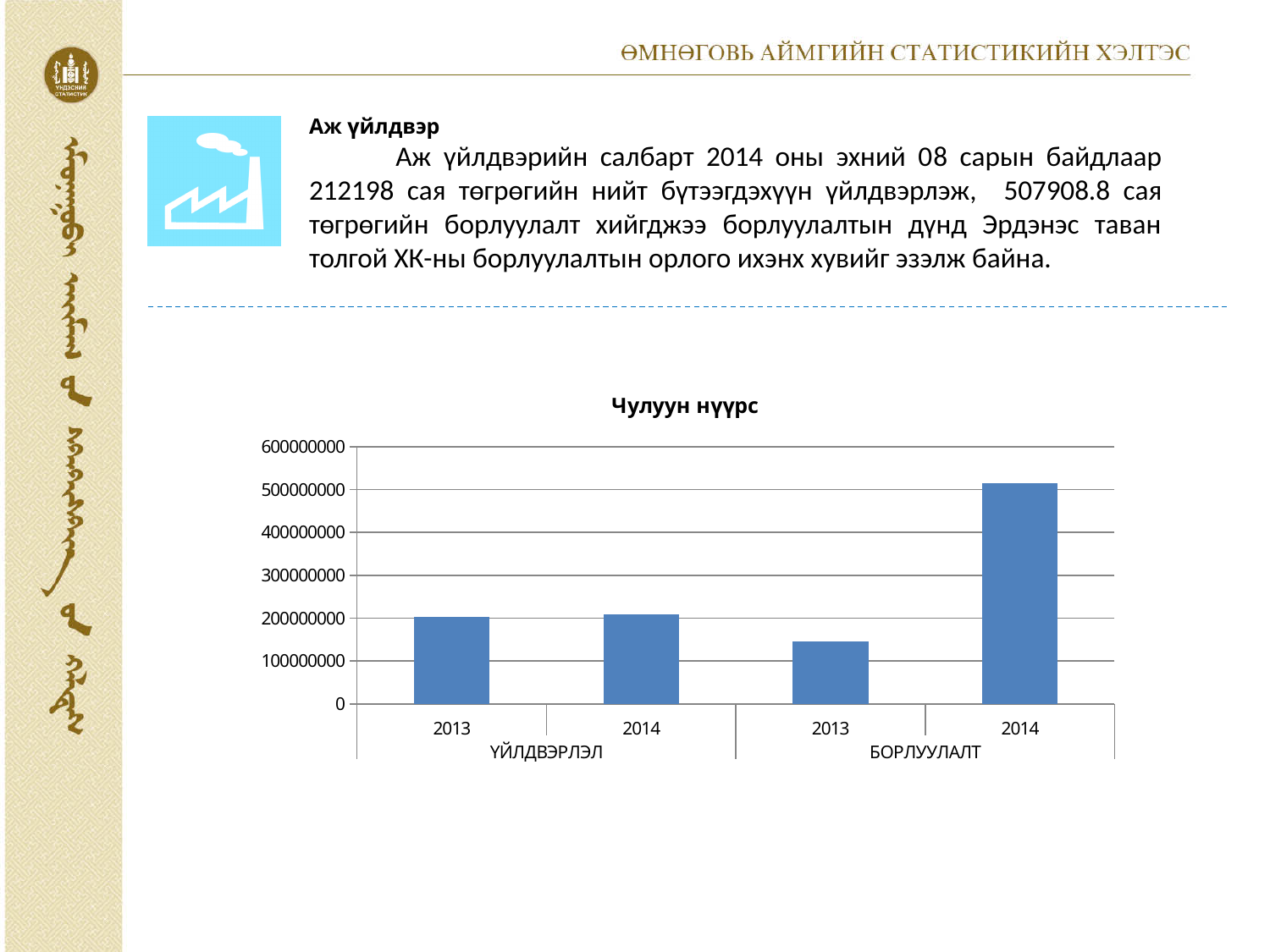
Is the value for ҮЙЛДВЭРЛЭЛ 2014 greater or less than 300000000? less How many bars are plotted in the chart? 4 Is the value for БОРЛУУЛАЛТ 2014 greater or less than 400000000? greater Which bar is the lowest in the chart? БОРЛУУЛАЛТ 2013 Which is larger, the value for ҮЙЛДВЭРЛЭЛ 2014 or the value for БОРЛУУЛАЛТ 2014? БОРЛУУЛАЛТ 2014 Is the value for БОРЛУУЛАЛТ 2013 greater or less than 200000000? less Does the value for БОРЛУУЛАЛТ rise or fall from 2013 to 2014? rise Which bar is the highest in the chart? БОРЛУУЛАЛТ 2014 What kind of chart is shown under the title "Чулуун нүүрс"? bar chart What is the title of the chart? Чулуун нүүрс What is the highest value shown on the vertical axis of the chart? 600000000